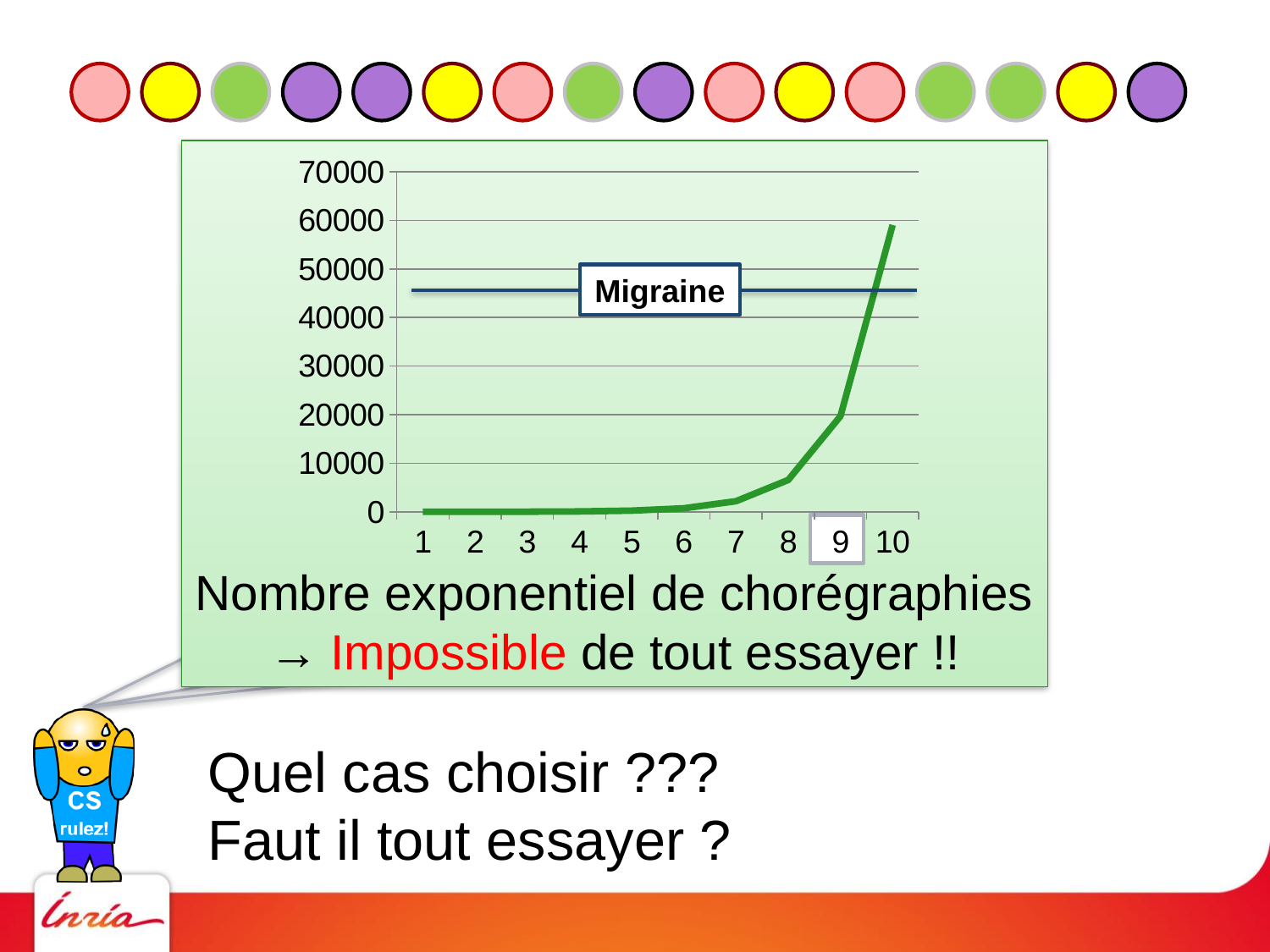
How many points are plotted along the x axis of the chart? 10 What kind of chart is shown on the slide? line chart Is the value of the green line at x = 9 greater or less than 10000? greater Is the horizontal line labelled 'Migraine' above or below 40000 on the y axis? above Which is larger, the value of the green line at x = 10 or at x = 8? x = 10 Is the value of the green line at x = 7 greater or less than 10000? less At which x-axis value does the green line reach its highest point? 10 Do the values of the green line rise or fall as the x axis goes from 1 to 10? rise What colour is the rising curve in the chart? green What label is shown on the horizontal line crossing the chart? Migraine